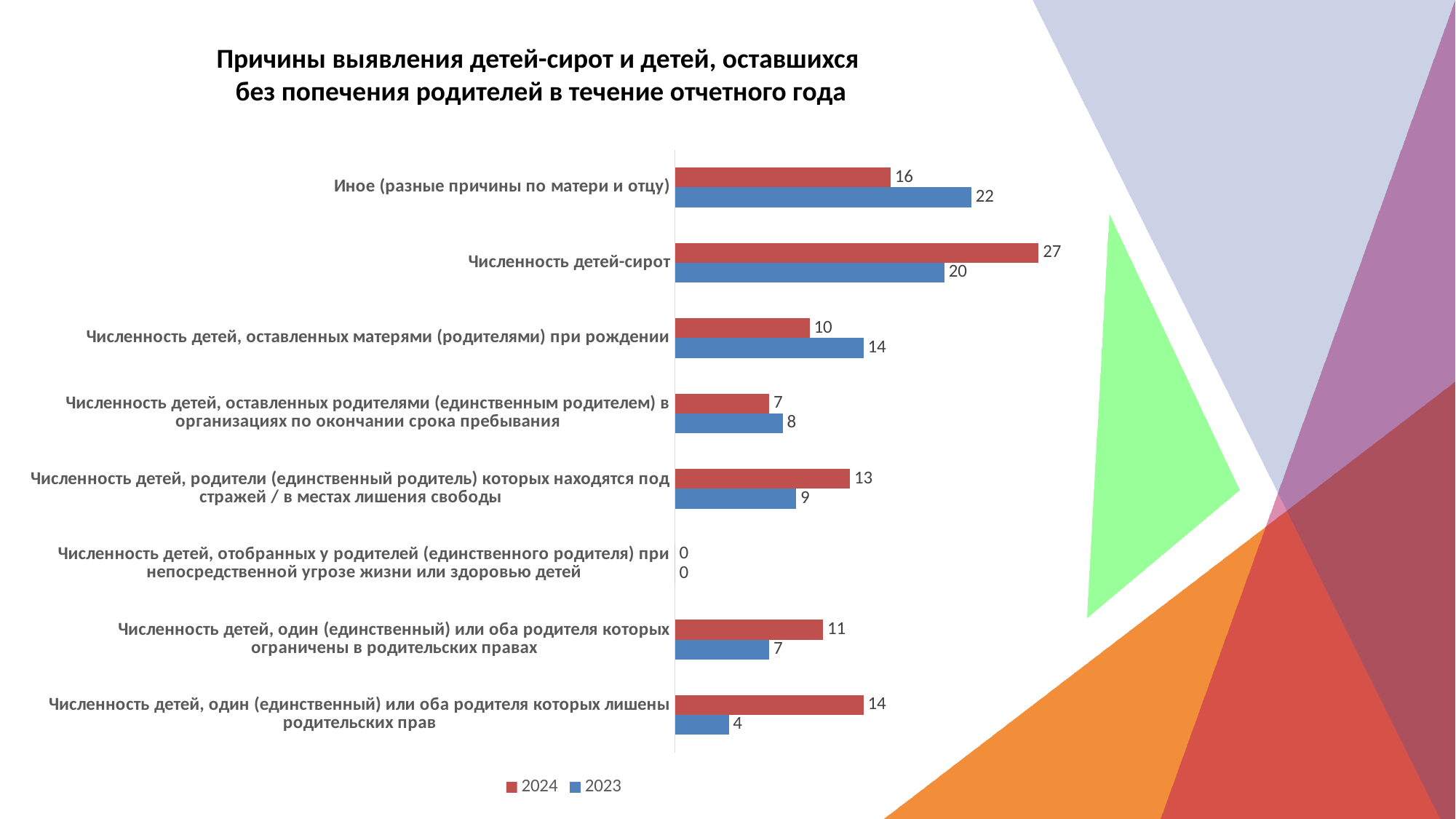
What is the 2024 value for "Численность детей-сирот"? 27 For "Численность детей, оставленных матерями (родителями) при рождении", which year has the larger value, 2024 or 2023? 2023 Which colour represents the 2024 series in the legend? red How many categories are shown on the chart? 8 What is the difference between the 2024 and 2023 values for "Численность детей, один (единственный) или оба родителя которых лишены родительских прав"? 10 What is the 2023 value for "Численность детей, один (единственный) или оба родителя которых лишены родительских прав"? 4 What is the 2023 value for "Иное (разные причины по матери и отцу)"? 22 How many series does the legend list? 2 Which category has the highest 2024 value? Численность детей-сирот What is the difference between the 2023 and 2024 values for "Иное (разные причины по матери и отцу)"? 6 Which category has the lowest 2023 value? Численность детей, отобранных у родителей (единственного родителя) при непосредственной угрозе жизни или здоровью детей What type of chart is shown on the slide? bar chart